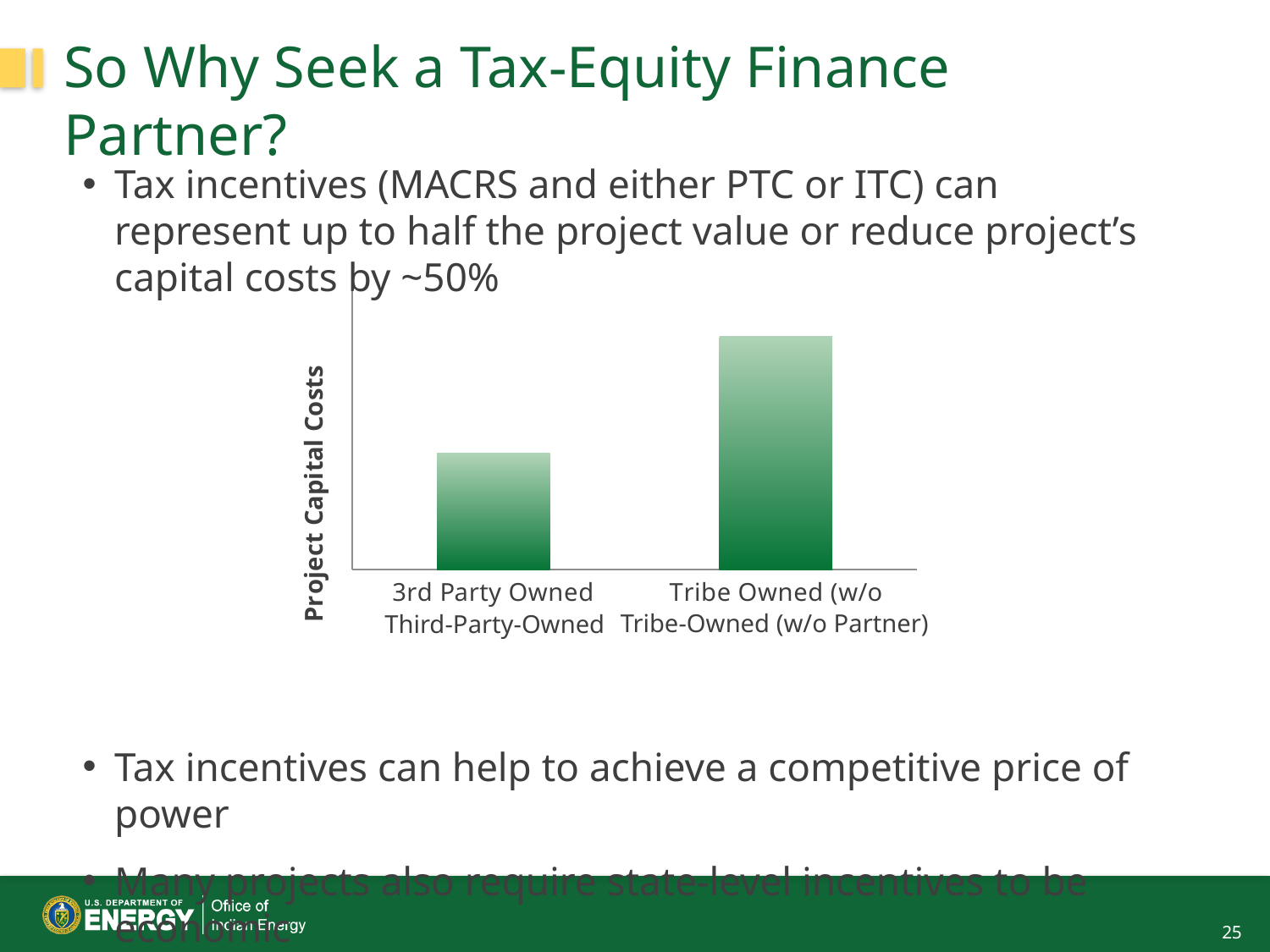
Which category has the lower project capital costs? Third-Party-Owned What colour are the bars in the chart? green Do the bar values rise or fall from left to right across the chart? rise How many bars does the chart show? 2 What is the title of the vertical axis of the chart? Project Capital Costs Which category has the higher project capital costs? Tribe-Owned (w/o Partner) What kind of chart is shown on the slide? bar chart Is the bar for Third-Party-Owned taller or shorter than the bar for Tribe-Owned (w/o Partner)? shorter